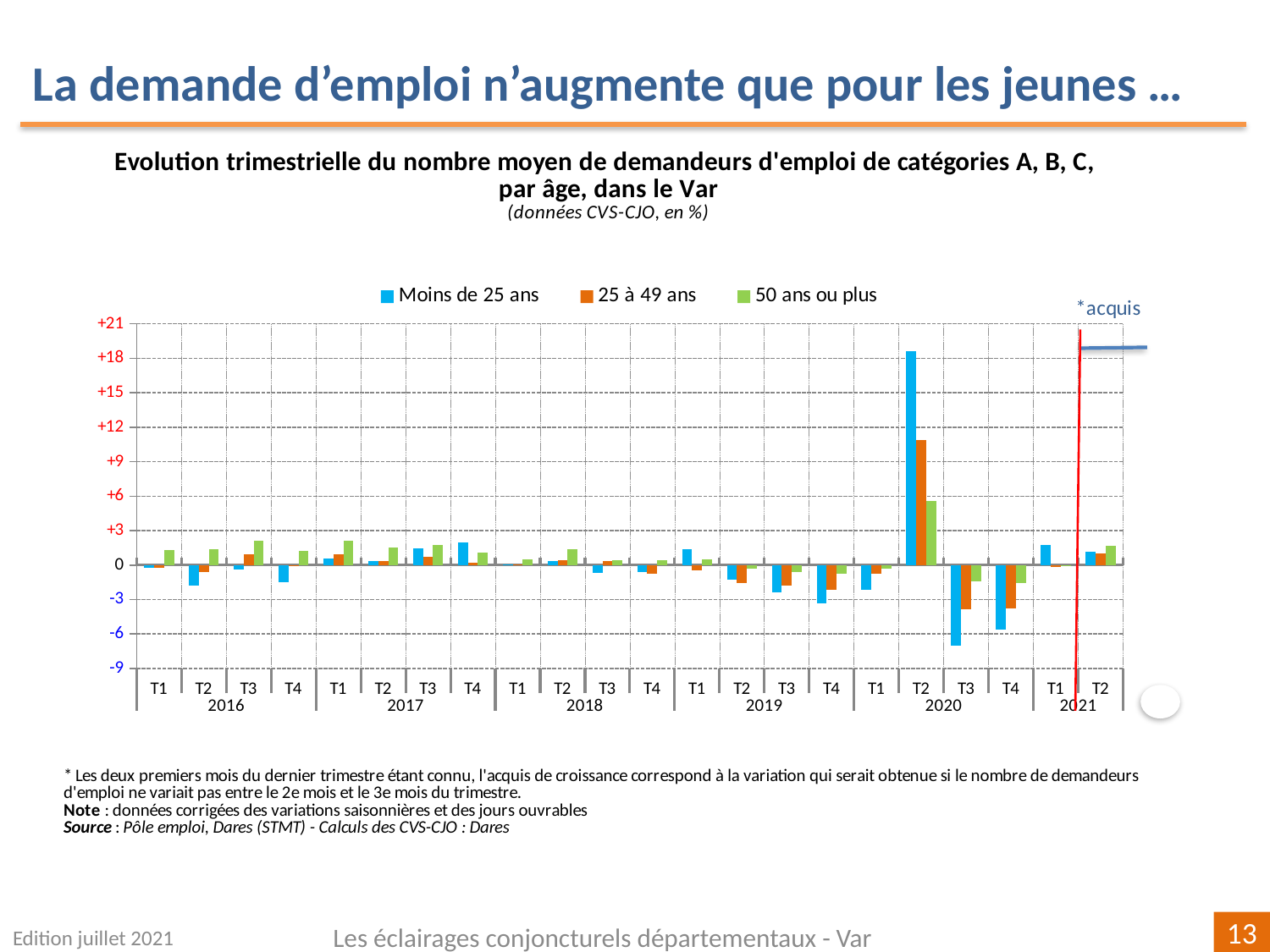
Is the value for 'Moins de 25 ans' in T2 2020 greater or less than +15? greater In which quarter does the 'Moins de 25 ans' series reach its highest value? T2 2020 What kind of chart is shown on the slide? bar chart How many series does the legend list? 3 Is the value for '50 ans ou plus' in T2 2020 greater or less than +3? greater In T2 2020, which is larger: the value for 'Moins de 25 ans' or for '25 à 49 ans'? Moins de 25 ans In T3 2020, which is larger: the value for '25 à 49 ans' or for '50 ans ou plus'? 50 ans ou plus Is the value for 'Moins de 25 ans' in T3 2020 greater or less than -6? less Which series does the legend show in blue? Moins de 25 ans How many quarters are plotted along the x axis? 22 In which quarter does the 'Moins de 25 ans' series reach its lowest value? T3 2020